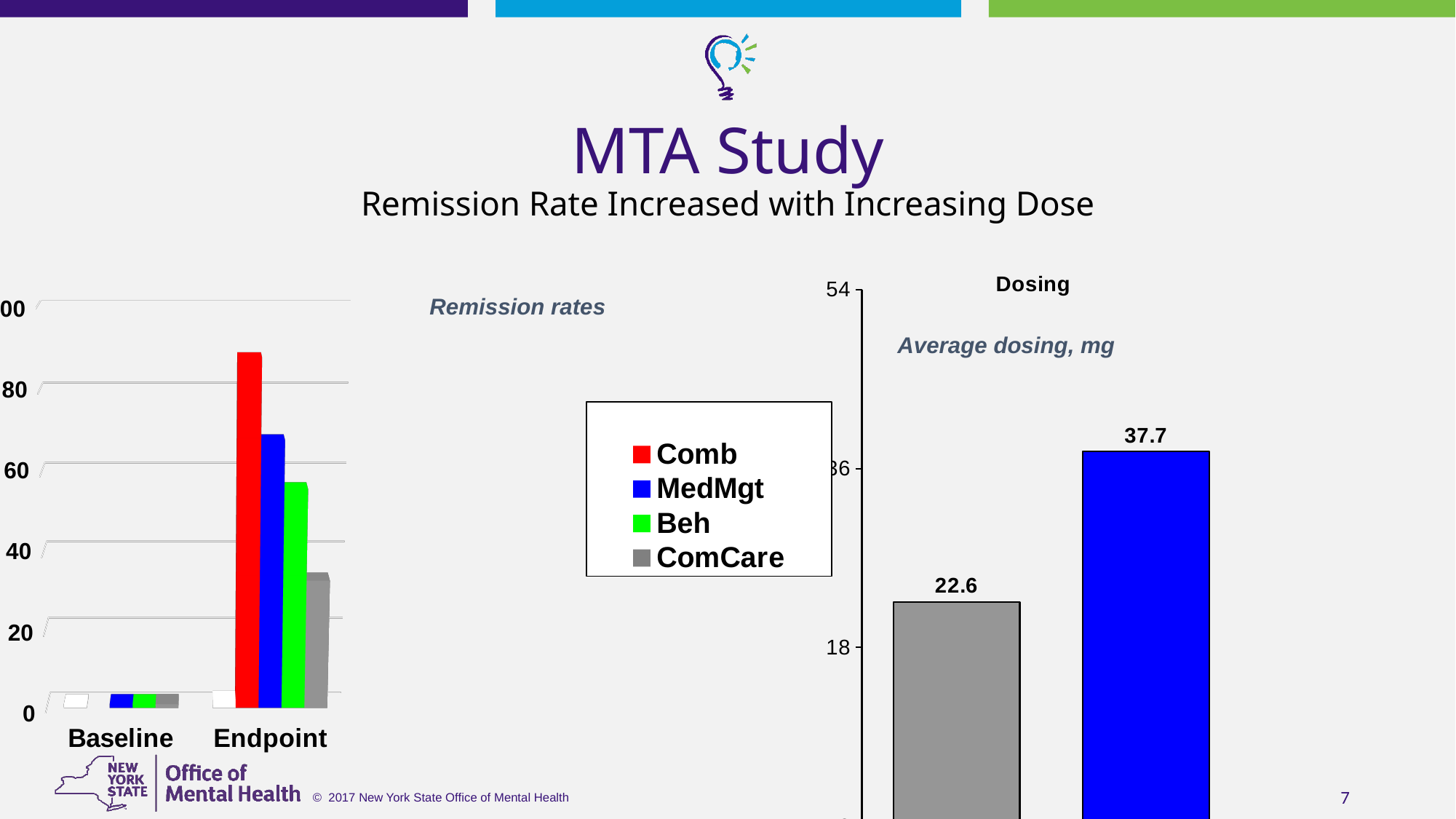
In the Remission rates chart, which is larger at Endpoint, Comb or MedMgt? Comb How many series does the legend list? 4 In the Dosing chart, what is the value shown on the gray bar? 22.6 In the Remission rates chart, which series has the highest value at Endpoint? Comb In the Dosing chart, what is the difference between the two bar values? 15.1 In the Remission rates chart, is the Endpoint value for Comb greater or less than 80? greater In the Remission rates chart, which series has the lowest value at Endpoint? ComCare In the Dosing chart, which bar is higher, the gray bar or the blue bar? the blue bar What kind of chart is the Dosing chart? bar chart In the Dosing chart, what is the value shown on the blue bar? 37.7 How many bars are plotted in the Dosing chart? 2 In the Remission rates chart, is the Endpoint value for ComCare greater or less than 40? less